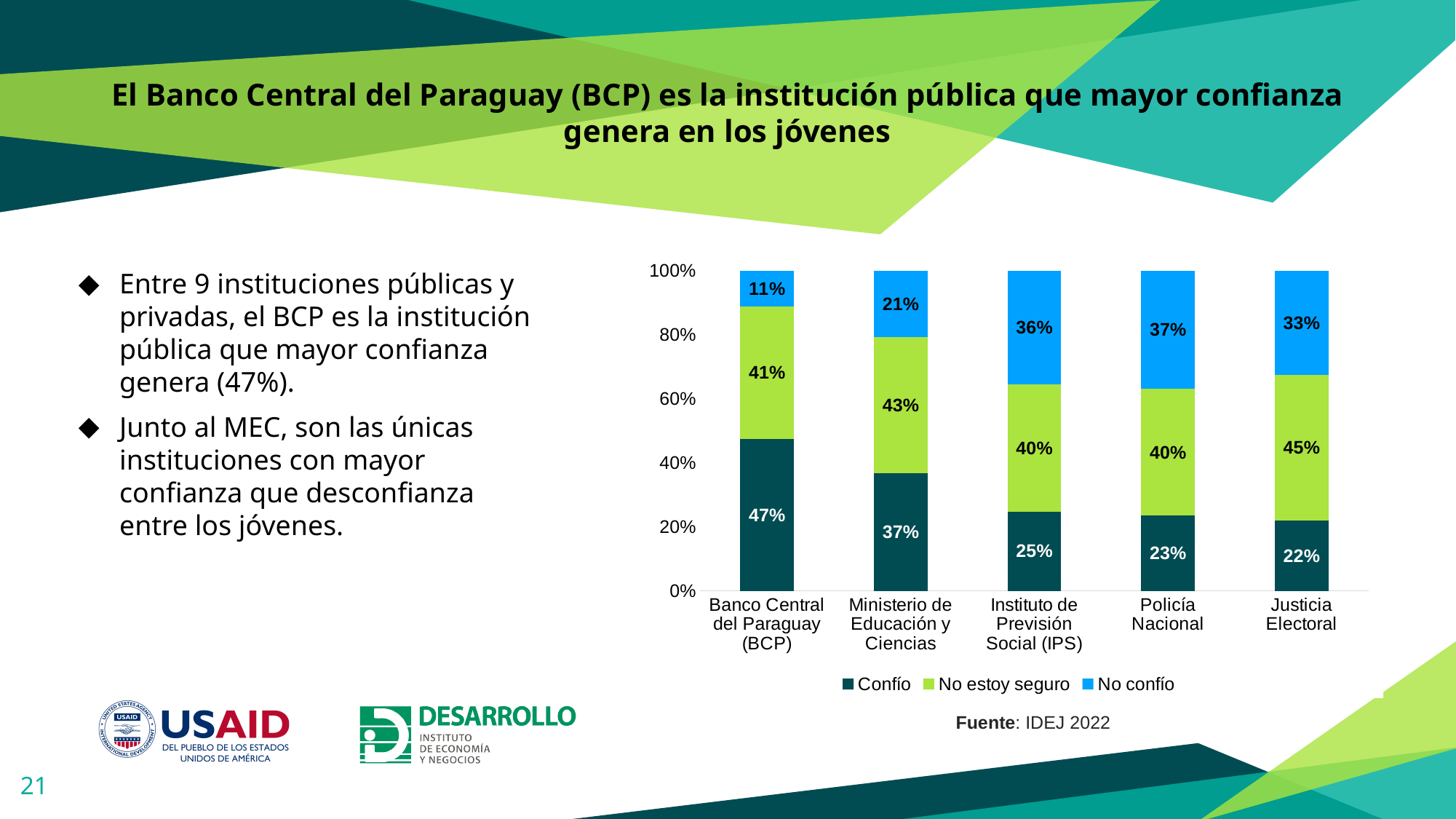
What is the 'No estoy seguro' value for Justicia Electoral? 45% What kind of chart is shown? Stacked bar chart Which institution has the highest 'Confío' value? Banco Central del Paraguay (BCP) How many series does the legend list? 3 Do the 'Confío' values rise or fall from left to right along the x axis? Fall What is the 'No confío' value for Policía Nacional? 37% What is the 'Confío' value for Banco Central del Paraguay (BCP)? 47% Which institution has the lowest 'No confío' value? Banco Central del Paraguay (BCP) Which is larger: the 'No confío' value for Instituto de Previsión Social (IPS) or for Justicia Electoral? Instituto de Previsión Social (IPS) How many institutions are shown on the x axis? 5 What source is cited below the chart? IDEJ 2022 What is the difference between the 'Confío' values for Banco Central del Paraguay (BCP) and Ministerio de Educación y Ciencias? 10%